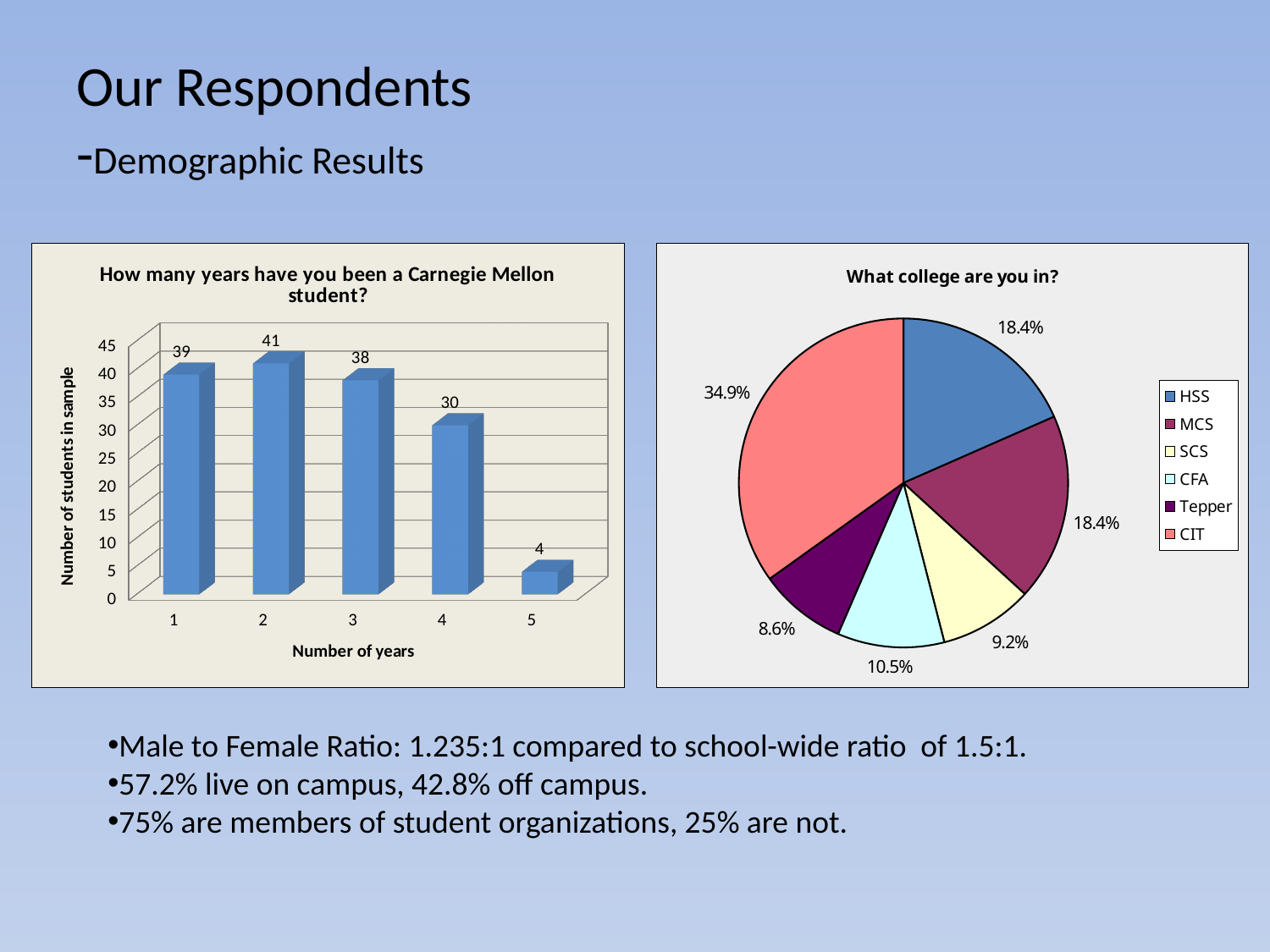
In the chart titled "How many years have you been a Carnegie Mellon student?", how many students have been a student for 5 years? 4 In the chart titled "What college are you in?", what share of respondents are in CIT? 34.9% In the chart titled "How many years have you been a Carnegie Mellon student?", which has more students: 1 year or 3 years? 1 year In the chart titled "What college are you in?", what share of respondents are in Tepper? 8.6% In the chart titled "What college are you in?", which college has the largest slice? CIT In the chart titled "How many years have you been a Carnegie Mellon student?", which number of years has the highest number of students? 2 In the chart titled "How many years have you been a Carnegie Mellon student?", how many categories are shown on the x axis? 5 In the chart titled "What college are you in?", how many colleges does the legend list? 6 In the chart titled "How many years have you been a Carnegie Mellon student?", how many students have been a student for 2 years? 41 What kind of chart is the chart titled "How many years have you been a Carnegie Mellon student?"? Bar chart In the chart titled "How many years have you been a Carnegie Mellon student?", what is the difference between the number of students at 1 year and at 4 years? 9 In the chart titled "How many years have you been a Carnegie Mellon student?", which number of years has the lowest number of students? 5